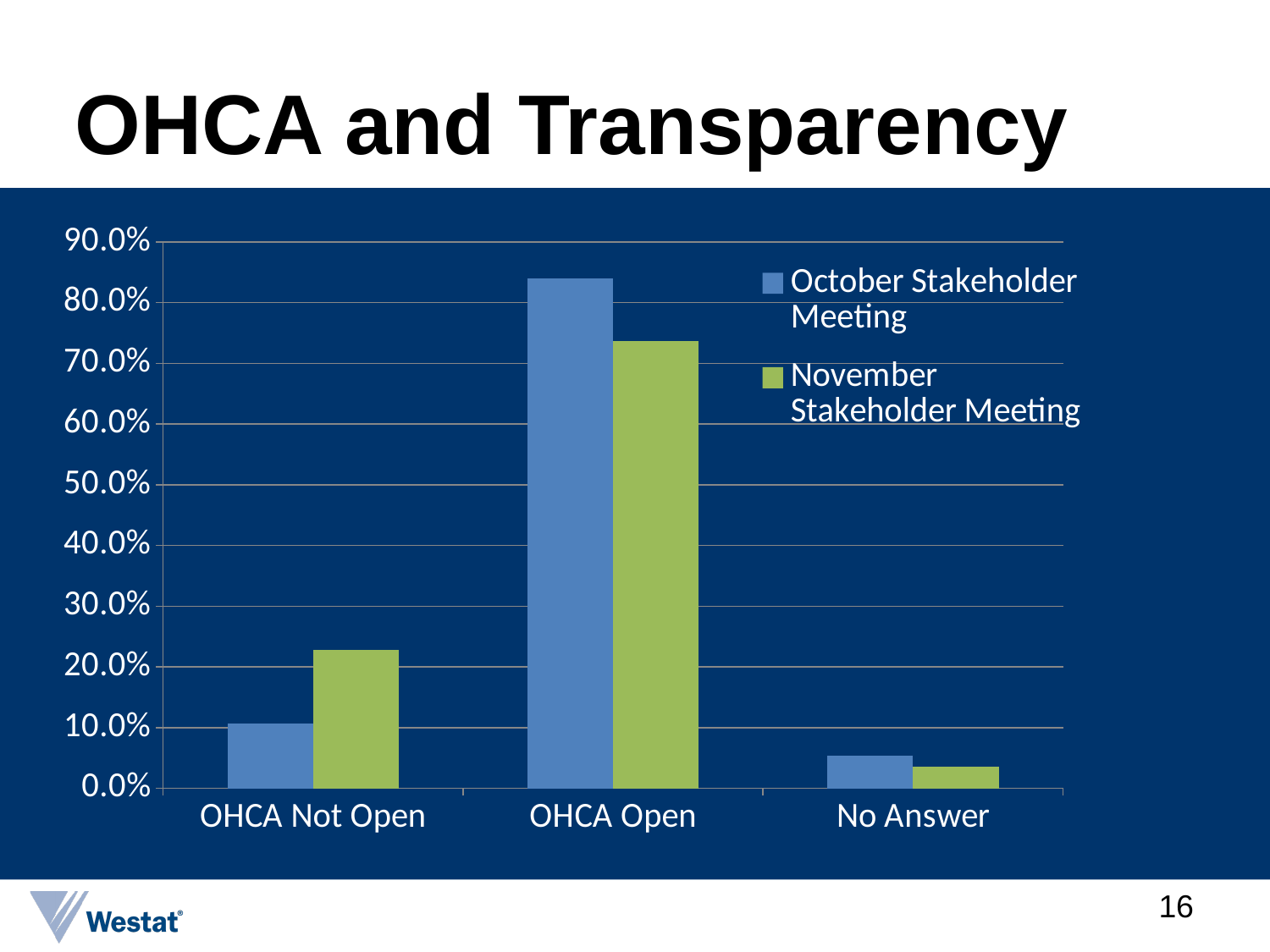
Which category has the highest value for the October Stakeholder Meeting series? OHCA Open Is the November Stakeholder Meeting value for OHCA Not Open greater or less than 20.0%? greater What kind of chart is shown on the slide? bar chart Is the November Stakeholder Meeting value for OHCA Open greater or less than 80.0%? less Is the October Stakeholder Meeting value for No Answer greater or less than 10.0%? less For OHCA Not Open, which series has the larger value: October Stakeholder Meeting or November Stakeholder Meeting? November Stakeholder Meeting How many series does the chart's legend list? 2 For OHCA Open, which series has the larger value: October Stakeholder Meeting or November Stakeholder Meeting? October Stakeholder Meeting How many categories are shown on the x axis of the chart? 3 Which category has the lowest value for the November Stakeholder Meeting series? No Answer Which colour represents the November Stakeholder Meeting series in the chart? green